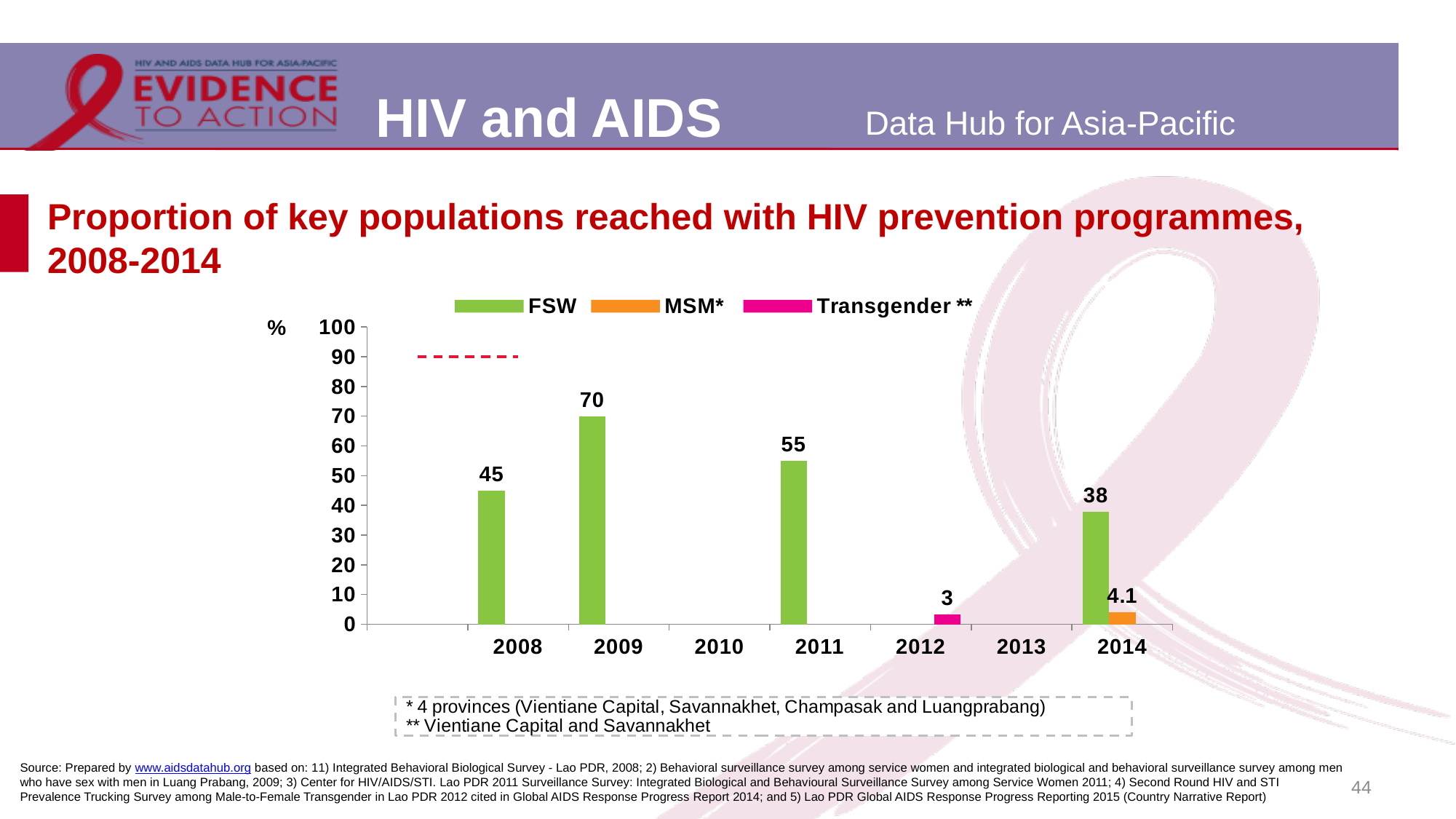
What kind of chart is shown on the slide? Bar chart In which year is the FSW value lowest among the years with an FSW bar? 2014 How many years are shown on the x axis? 7 Which is larger, the FSW value in 2011 or the FSW value in 2014? 2011 What is the value for FSW in 2009? 70 What is the value for MSM in 2014? 4.1 Which colour represents MSM in the legend? Orange How many series does the legend list? 3 What is the difference between the FSW values in 2009 and 2008? 25 What is the value for Transgender in 2012? 3 What is the value for FSW in 2014? 38 In which year is the FSW value highest? 2009